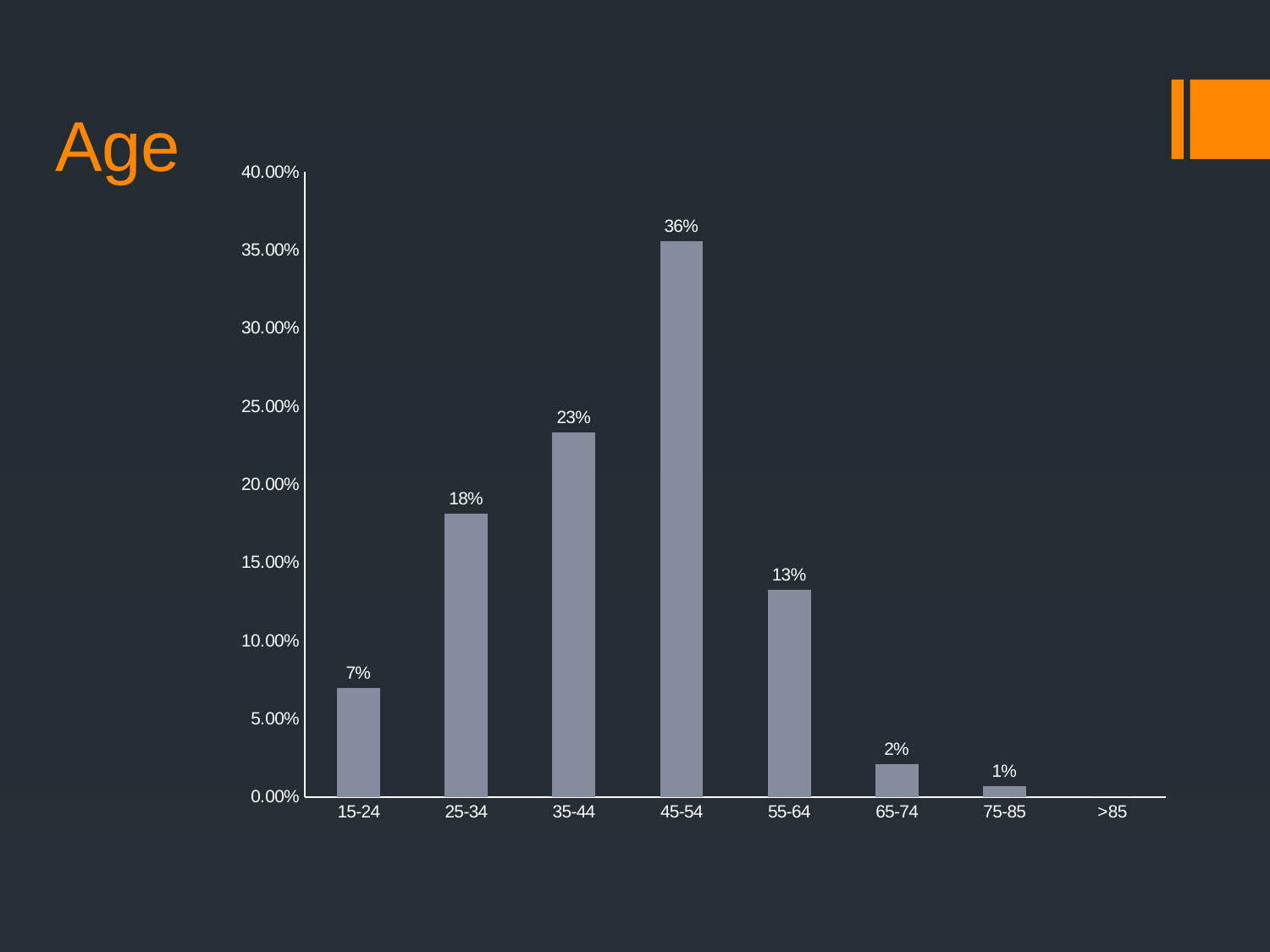
How many age categories are shown on the x axis? 8 Is the value for 35-44 greater or less than 20.00%? greater Which age group has the highest value? 45-54 What is the title of the slide? Age Which is larger, the value for 25-34 or the value for 55-64? 25-34 What is the difference between the values for 25-34 and 55-64? 5% What is the difference between the values for 45-54 and 35-44? 13% What is the value for the 15-24 age group? 7% What is the value for the 65-74 age group? 2% Which age group with a visible bar has the lowest value? 75-85 What kind of chart is shown on the slide? bar chart What is the value for the 45-54 age group? 36%